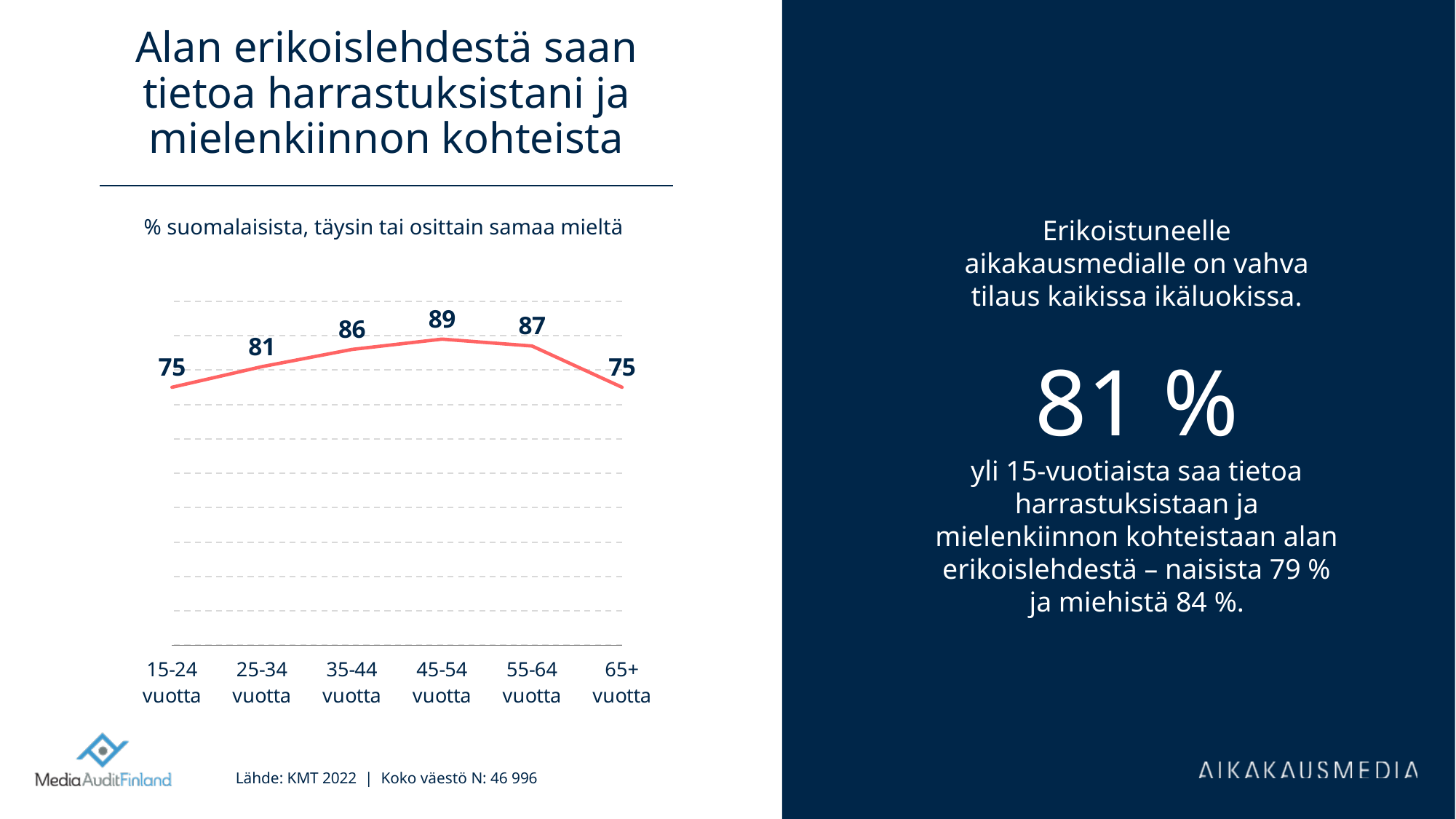
What kind of chart is shown on the slide? Line chart What is the value for the 45-54 vuotta age group? 89 What is the value for the 55-64 vuotta age group? 87 What is the difference between the values for 45-54 vuotta and 15-24 vuotta? 14 What is the value for the 25-34 vuotta age group? 81 What is the difference between the values for 35-44 vuotta and 25-34 vuotta? 5 What is the subtitle shown above the chart? % suomalaisista, täysin tai osittain samaa mieltä What is the value for the 65+ vuotta age group? 75 Which age group has the highest value? 45-54 vuotta How many age groups are plotted on the chart? 6 Do the values rise or fall from 15-24 vuotta to 45-54 vuotta? Rise Which is larger, the value for 35-44 vuotta or the value for 55-64 vuotta? 55-64 vuotta